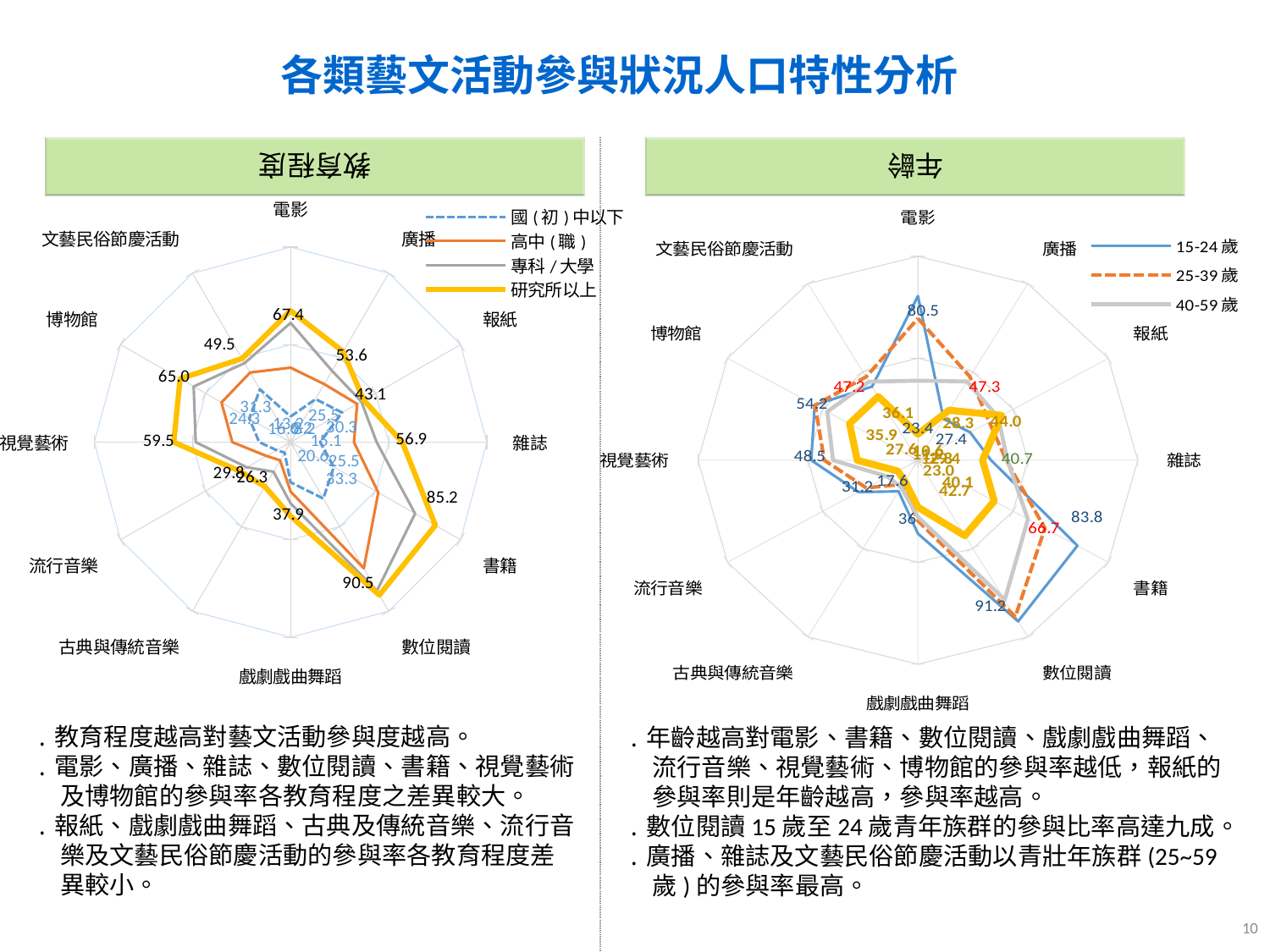
In the left chart (教育程度), what is the value for 電影 for the 研究所以上 series? 67.4 In the left chart (教育程度), which series is drawn with the thick yellow line? 研究所以上 In the right chart (年齡), what is the value for 數位閱讀 for the 15-24歲 series? 91.2 In the left chart (教育程度), which category has the highest value for the 研究所以上 series? 數位閱讀 In the right chart (年齡), which is larger for the 15-24歲 series: 電影 or 數位閱讀? 數位閱讀 What kind of chart is the left chart (教育程度)? radar chart How many series does the legend of the left chart (教育程度) list? 4 How many series does the legend of the right chart (年齡) list? 3 In the left chart (教育程度), what is the difference between 數位閱讀 (90.5) and 書籍 (85.2) for the 研究所以上 series? 5.3 In the left chart (教育程度), what is the value for 數位閱讀 for the 研究所以上 series? 90.5 In the left chart (教育程度), which category has the lowest value for the 研究所以上 series? 古典與傳統音樂 How many categories (axes) does the right chart (年齡) have? 12